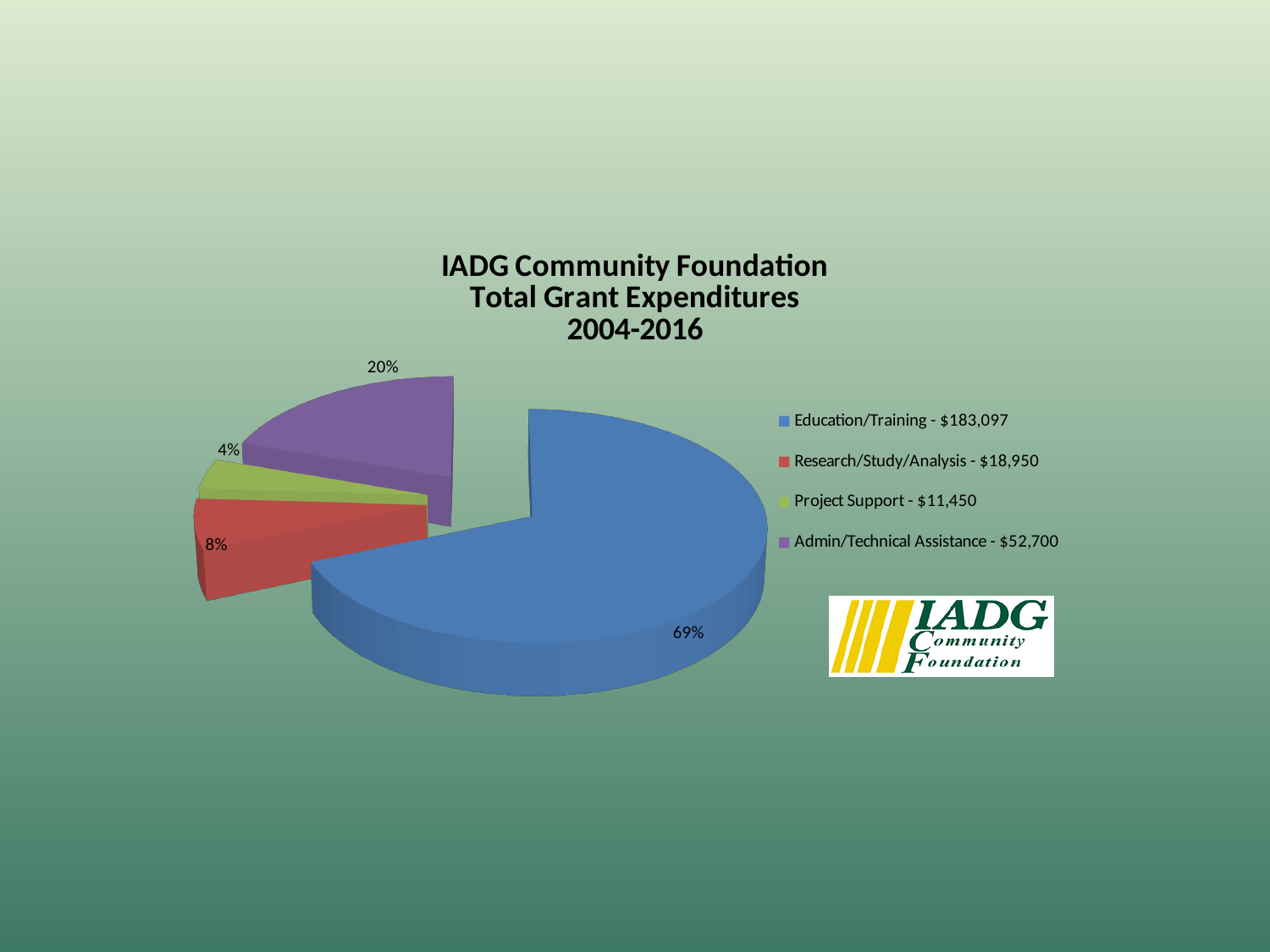
Which is larger, the share for Research/Study/Analysis or the share for Admin/Technical Assistance? Admin/Technical Assistance Which category has the largest share of the pie? Education/Training What kind of chart is shown on the slide? Pie chart What dollar amount is listed in the legend for Admin/Technical Assistance? $52,700 Which category has the smallest share of the pie? Project Support What dollar amount is listed in the legend for Education/Training? $183,097 What percentage share does Admin/Technical Assistance have in the pie chart? 20% How many categories are shown in the pie chart? 4 What is the difference in percentage points between the Education/Training share and the Admin/Technical Assistance share? 49 percentage points What percentage share does Project Support have in the pie chart? 4% What percentage share does Education/Training have in the pie chart? 69%